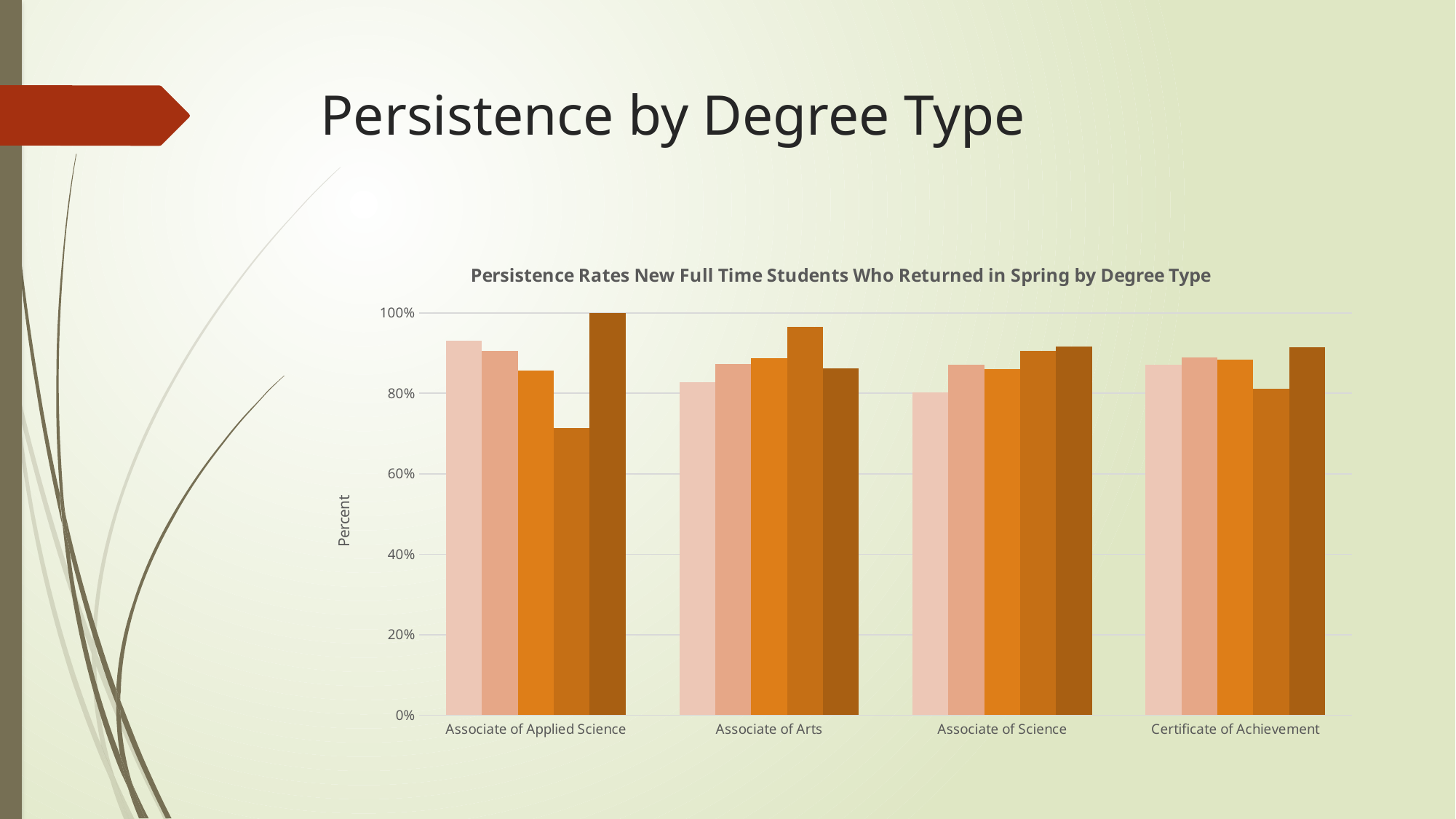
Is the value of the fourth bar for Associate of Applied Science greater or less than 80%? less What is the title of the chart? Persistence Rates New Full Time Students Who Returned in Spring by Degree Type How many degree-type categories are shown on the x axis of the chart? 4 What is the label on the vertical axis of the chart? Percent Which degree type has a bar that reaches 100%? Associate of Applied Science Is the value of the fourth bar for Associate of Arts greater or less than 80%? greater What value does the darkest (rightmost) bar for Associate of Applied Science reach? 100% What kind of chart is shown on the slide? bar chart Is the value of the first (lightest) bar for Associate of Applied Science greater or less than 80%? greater Within Associate of Arts, which bar is larger: the first (lightest) bar or the fourth bar? the fourth bar How many bars are plotted for each degree type in the chart? 5 Within Associate of Applied Science, which bar is larger: the fourth bar or the fifth (darkest) bar? the fifth (darkest) bar